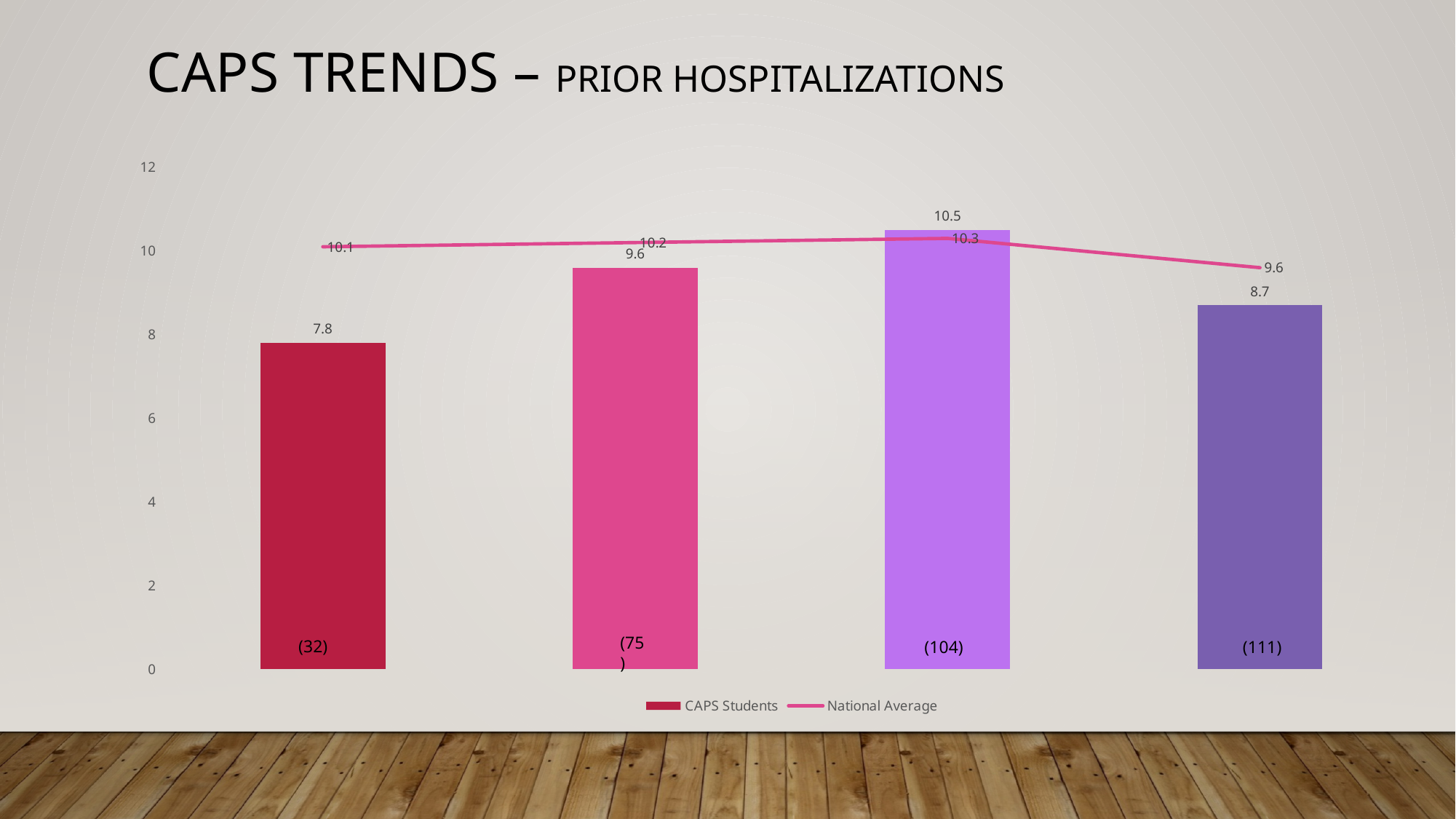
What is the National Average value at the fourth (rightmost) point? 9.6 Is the CAPS Students value for the fourth bar greater or less than 8? greater What is the difference between the CAPS Students value of the third bar and the first bar? 2.7 Which bar has the lowest CAPS Students value? The first bar (7.8) At the second position, which is larger: the CAPS Students value or the National Average value? National Average (10.2) What is the CAPS Students value for the first (leftmost) bar? 7.8 What is the CAPS Students value for the third bar? 10.5 Which bar has the highest CAPS Students value? The third bar (10.5) What kind of chart is shown on the slide? A bar chart with a line series How many series does the legend list? 2 How many bars are plotted in the chart? 4 What are the two series named in the legend? CAPS Students and National Average